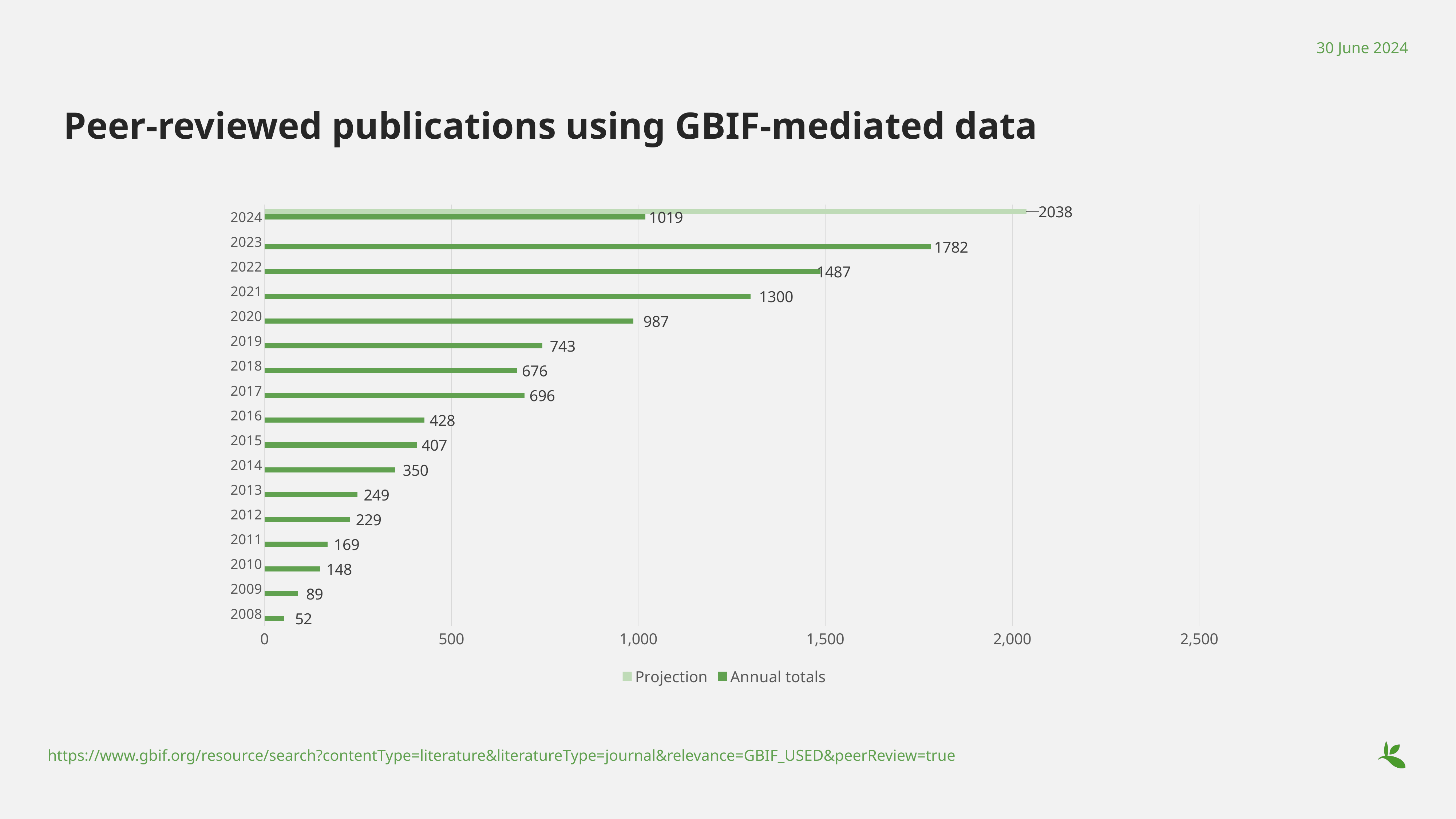
Which year has the lowest annual total? 2008 Is the annual total for 2021 greater or less than 1,000? greater What is the title of the chart? Peer-reviewed publications using GBIF-mediated data What is the annual total for 2008? 52 Which year has a larger annual total, 2017 or 2018? 2017 What is the projected value for 2024? 2038 How many years are shown on the chart? 17 What kind of chart is shown on the slide? Bar chart What is the difference between the annual totals for 2023 and 2022? 295 What is the annual total of peer-reviewed publications for 2023? 1782 Which year has the highest annual total? 2023 How many series does the legend list? 2